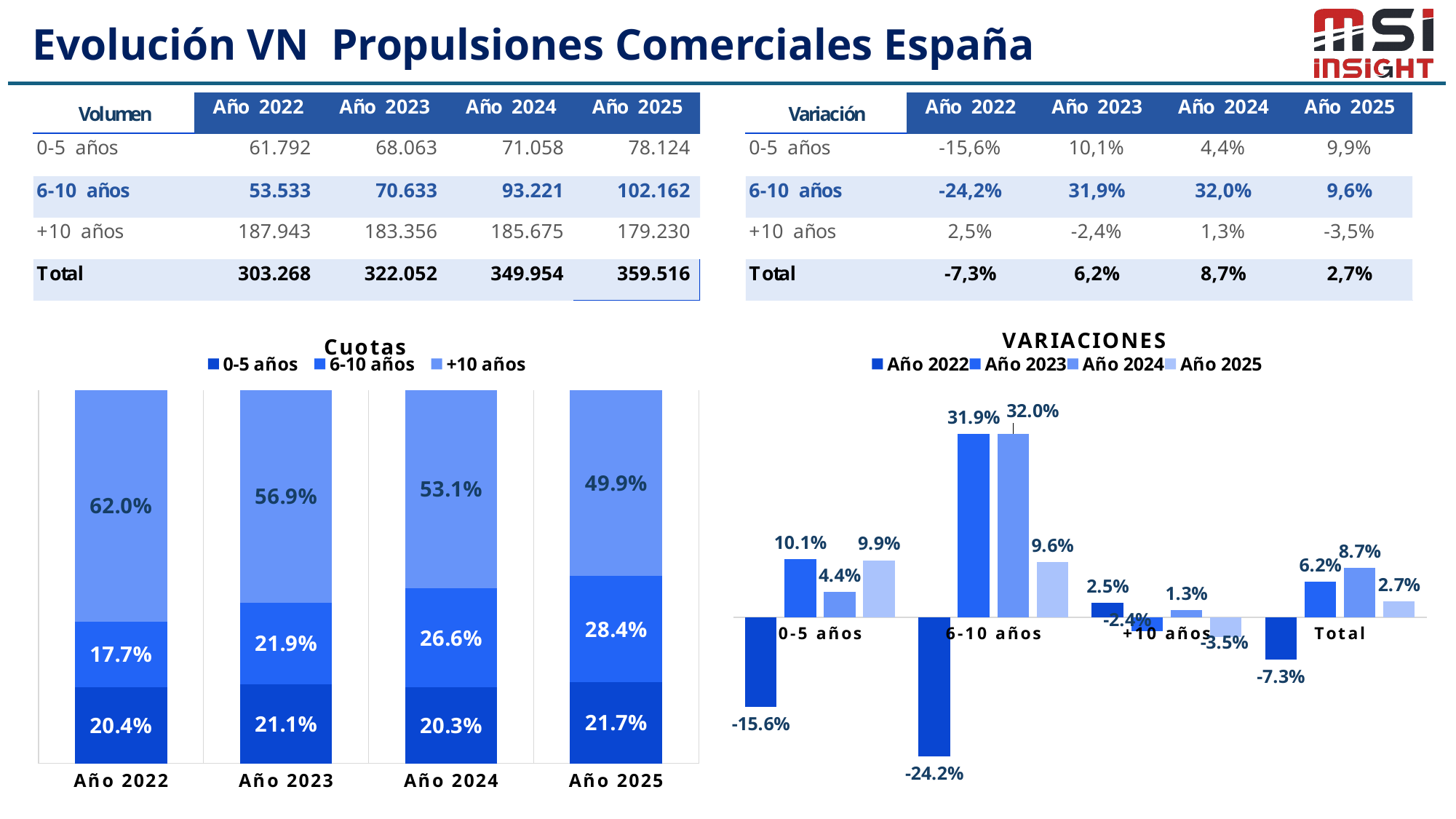
How many categories are shown on the x axis of the VARIACIONES chart? 4 In the VARIACIONES chart, which category has the lowest value in Año 2022? 6-10 años How many series does the legend of the Cuotas chart list? 3 In the Cuotas chart, what is the difference between the +10 años share in Año 2022 and in Año 2025? 12.1% In the VARIACIONES chart, which is larger for 0-5 años: Año 2023 or Año 2024? Año 2023 In the Cuotas chart, what is the share of +10 años in Año 2022? 62.0% In the Cuotas chart, what is the share of 6-10 años in Año 2025? 28.4% In the Cuotas chart, does the share of 6-10 años rise or fall from Año 2022 to Año 2025? rise In the VARIACIONES chart, what is the value for 6-10 años in Año 2022? -24.2% What kind of chart is the Cuotas chart? stacked bar chart In the Cuotas chart, which year has the lowest share for +10 años? Año 2025 In the VARIACIONES chart, what is the value for Total in Año 2024? 8.7%